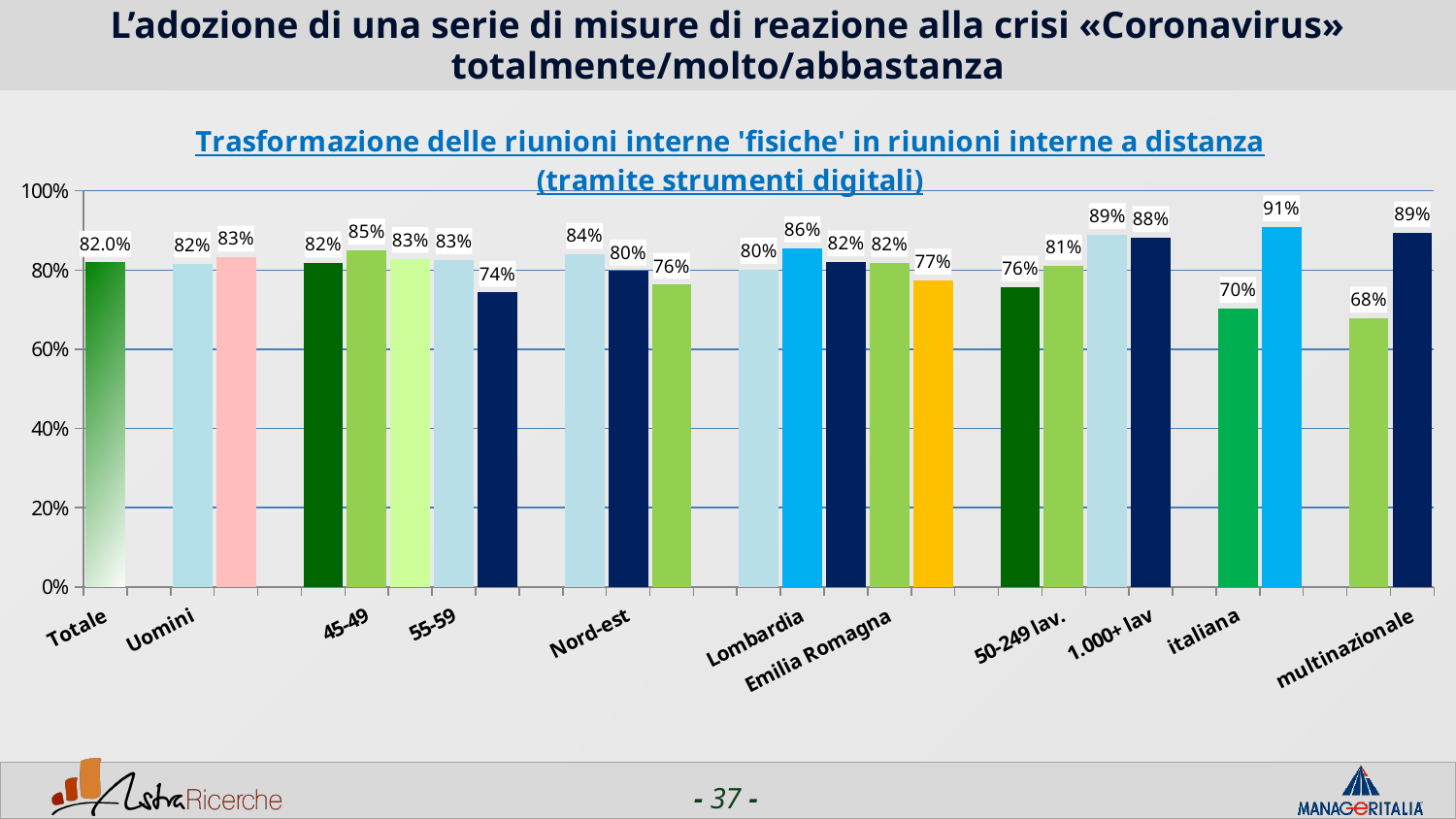
What kind of chart is shown on the slide? Bar chart Which is larger, the value for 'Lombardia' or the value for 'Totale'? Lombardia How many bars are plotted in the chart? 24 Is the value for 'Uomini' greater or less than 60%? greater What is the value shown for 'multinazionale'? 89% What is the value shown for 'Uomini'? 82% What is the value shown for 'Lombardia'? 86% What is the lowest value labelled on any bar in the chart? 68% Is the value for 'multinazionale' greater or less than 80%? greater What is the highest value labelled on any bar in the chart? 91% What is the value shown for the 'Totale' bar? 82.0% What is the highest value shown on the vertical axis? 100%